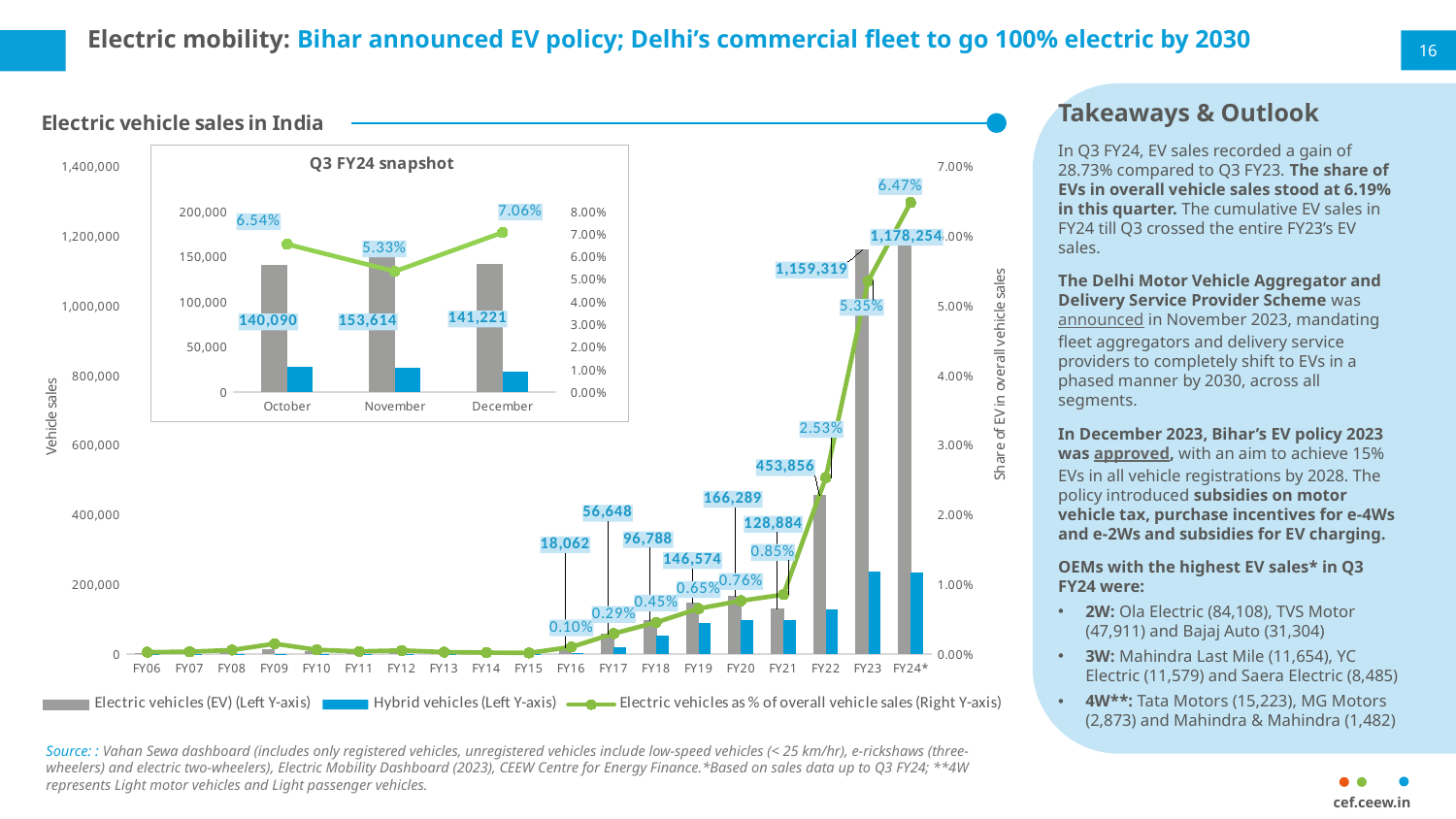
In the Q3 FY24 snapshot chart, what was the share of electric vehicles in overall vehicle sales in December? 7.06% In the Q3 FY24 snapshot chart, what is the difference between electric vehicle sales in November and October? 13,524 What kind of chart is the Electric vehicle sales in India chart? Combined bar and line chart In the Electric vehicle sales in India chart, is the hybrid vehicle value for FY24* greater or less than 400,000? less In the Electric vehicle sales in India chart, which year had higher electric vehicle sales, FY20 or FY21? FY20 In the Electric vehicle sales in India chart, what share of overall vehicle sales did electric vehicles have in FY24*? 6.47% In the Electric vehicle sales in India chart, which labelled year has the lowest share of electric vehicles in overall vehicle sales? FY16 In the Q3 FY24 snapshot chart, which month had the highest electric vehicle sales? November In the Electric vehicle sales in India chart, does the share of electric vehicles in overall vehicle sales rise or fall from FY16 to FY24*? Rise How many series does the legend of the Electric vehicle sales in India chart list? 3 In the Electric vehicle sales in India chart, what were electric vehicle sales in FY23? 1,159,319 In the Electric vehicle sales in India chart, what is the difference between electric vehicle sales in FY24* and FY23? 18,935